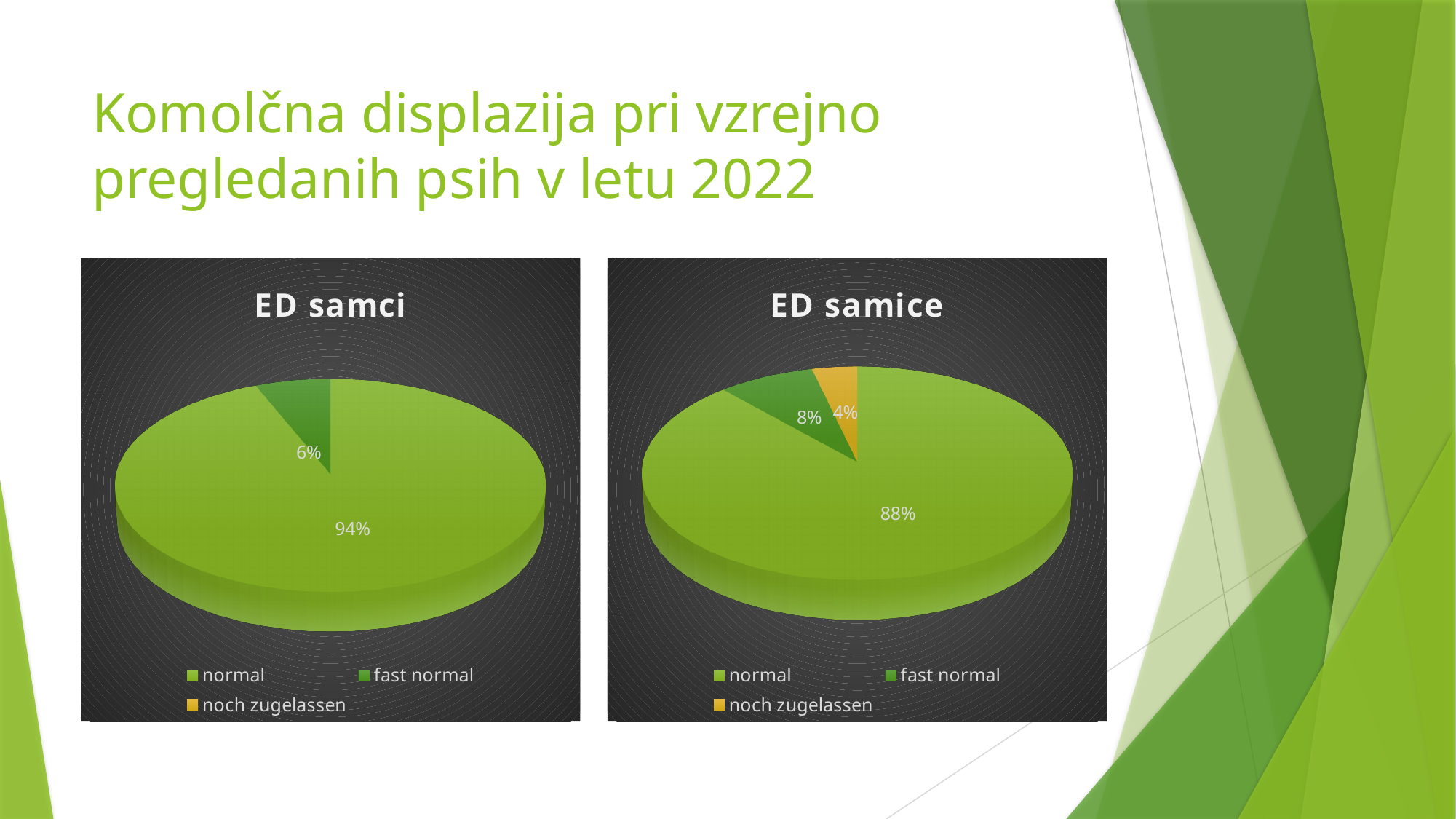
In the ED samice chart, what share of the pie is the noch zugelassen slice? 4% What type of chart is the ED samci chart? pie chart How many entries does the legend of the ED samice chart list? 3 In the ED samice chart, what share of the pie is the fast normal slice? 8% In the ED samice chart, which category has the largest slice? normal In the ED samice chart, which category has the smallest labelled slice? noch zugelassen What is the difference between the normal share in the ED samci chart and the normal share in the ED samice chart? 6% How many slices with labels are shown in the ED samice chart? 3 Which chart has the larger fast normal share, ED samci or ED samice? ED samice In the ED samice chart, what share of the pie is the normal slice? 88%